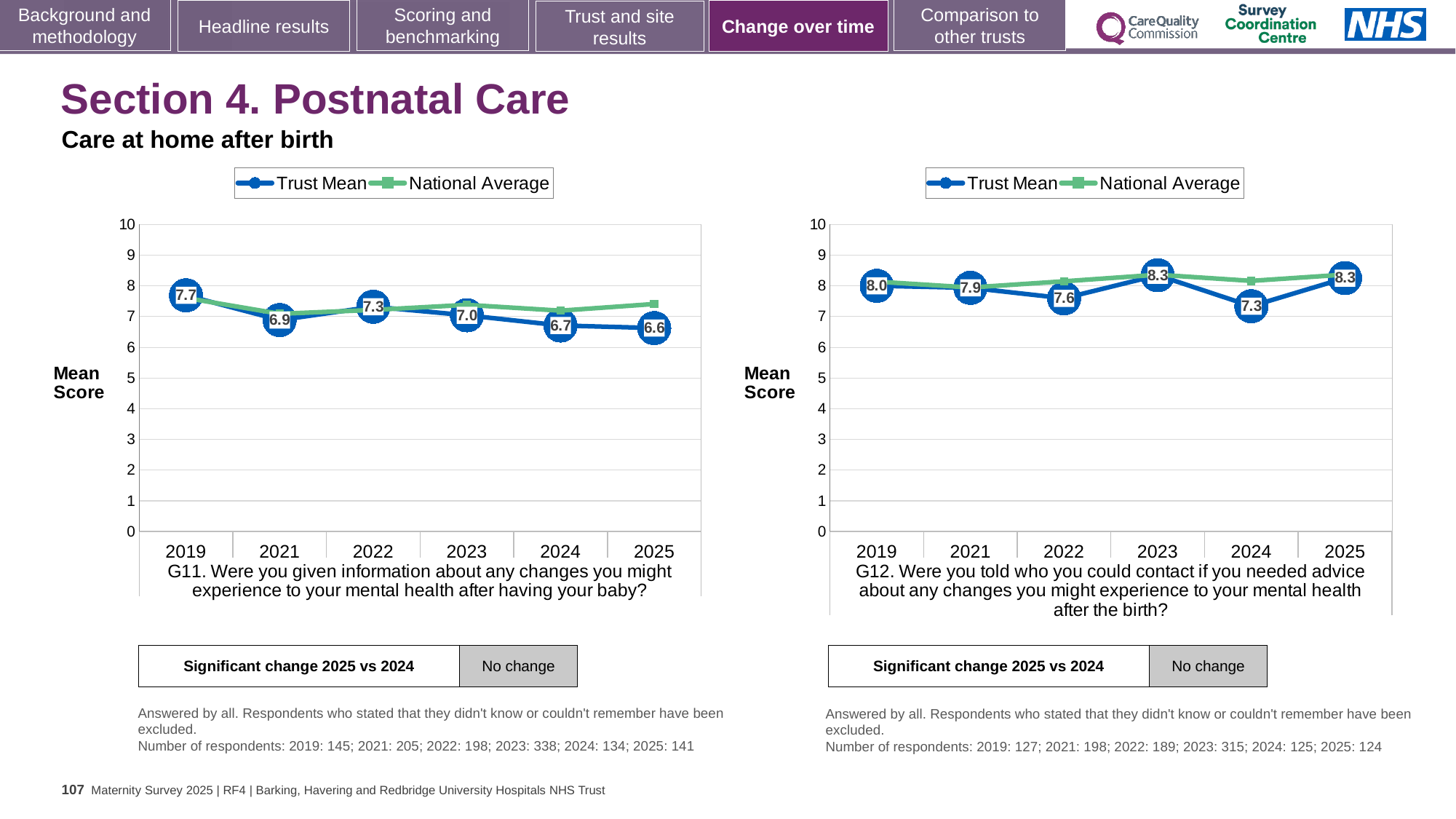
On the G12 chart (right), what is the Trust Mean score for 2024? 7.3 On the G11 chart (left), what is the Trust Mean score for 2019? 7.7 On the G11 chart (left), which year has the highest Trust Mean score? 2019 How many series does the legend of the G11 chart (left) list? 2 On the G12 chart (right), is the Trust Mean score for 2021 or 2024 larger? 2021 On the G12 chart (right), how many years are plotted on the x axis? 6 On the G11 chart (left), what is the difference between the Trust Mean scores for 2019 and 2025? 1.1 On the G12 chart (right), what is the Trust Mean score for 2022? 7.6 On the G11 chart (left), what is the Trust Mean score for 2025? 6.6 On the G11 chart (left), which year has the lowest Trust Mean score? 2025 What kind of chart is the G12 chart (right)? Line chart On the G12 chart (right), which year has the lowest Trust Mean score? 2024